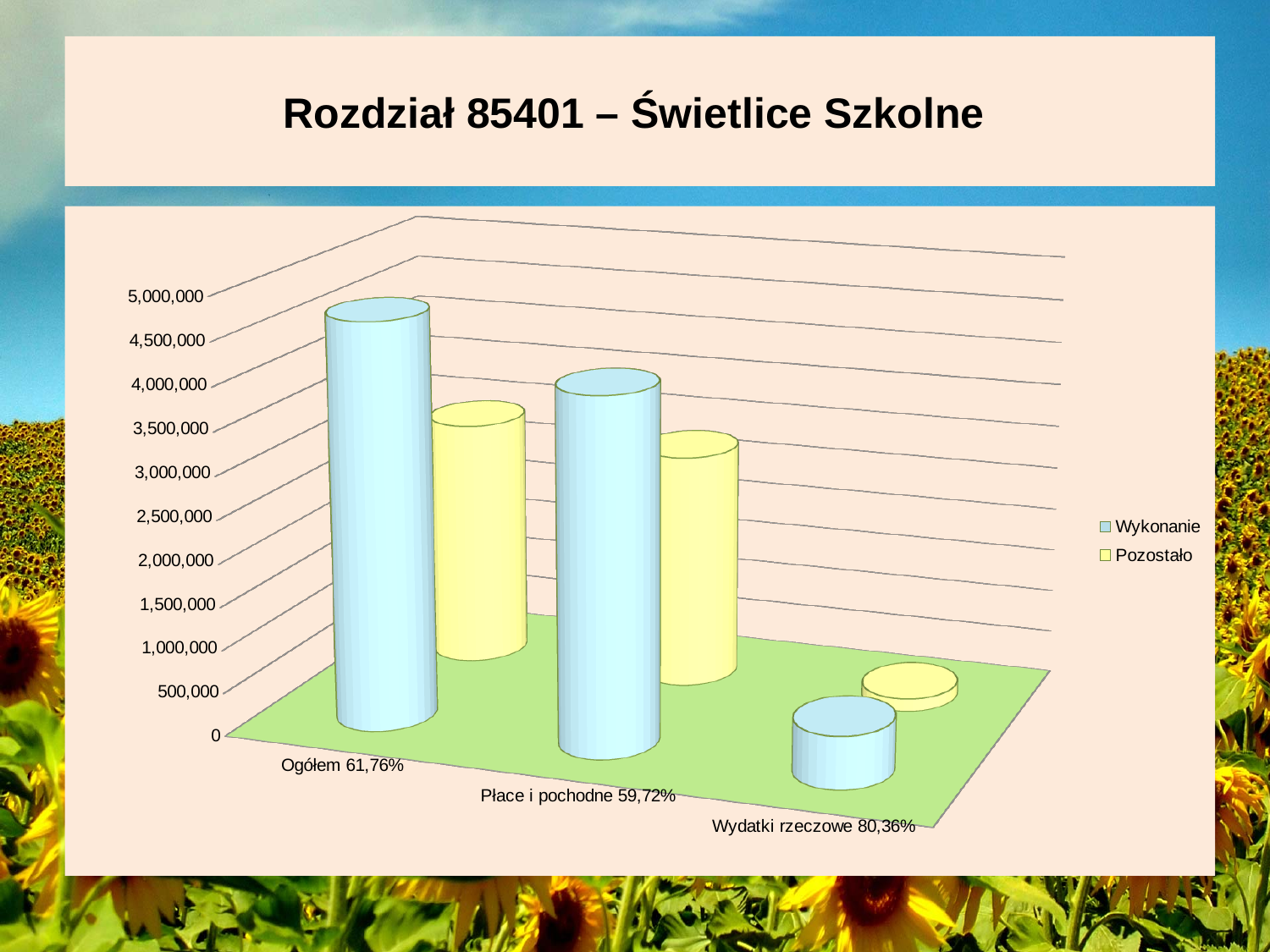
Is the Wykonanie value for Ogółem greater or less than 3,000,000? greater Which category has the highest Wykonanie value? Ogółem 61,76% How many series does the chart's legend list? 2 Which category has the larger Wykonanie value: Ogółem or Płace i pochodne? Ogółem How many categories are shown on the x axis of the chart? 3 Which category has the lowest Pozostało value? Wydatki rzeczowe 80,36% What kind of chart is shown on the slide? bar chart Is the Wykonanie value for Wydatki rzeczowe greater or less than 1,000,000? less Which is larger for Ogółem: Wykonanie or Pozostało? Wykonanie Is the Wykonanie value for Płace i pochodne greater or less than 2,000,000? greater What is the title of the slide containing the chart? Rozdział 85401 – Świetlice Szkolne Which category has the lowest Wykonanie value? Wydatki rzeczowe 80,36%